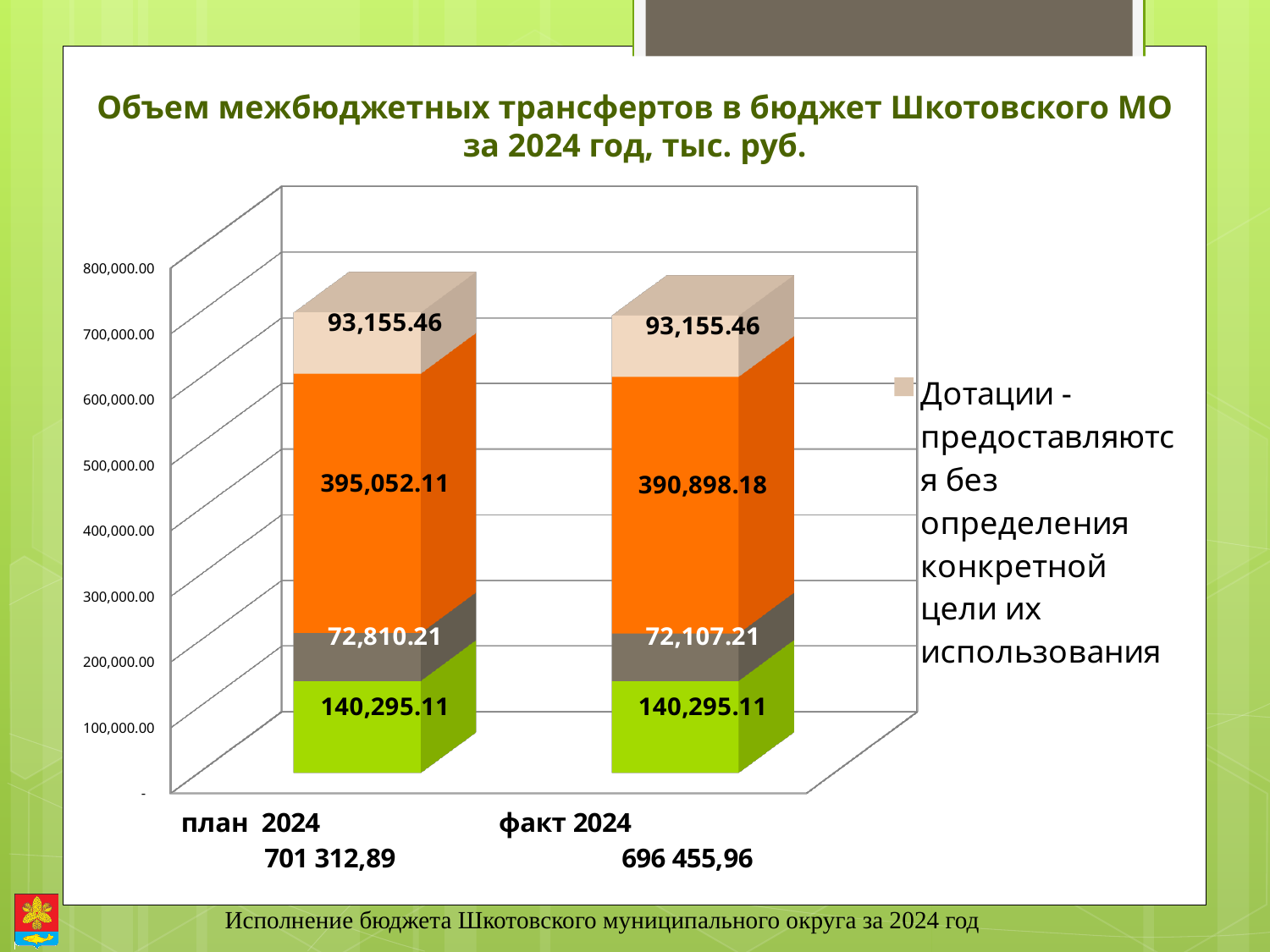
What is the value of the bottom green segment in the план 2024 bar? 140,295.11 What is the total shown for the факт 2024 bar? 696 455,96 How many categories are shown on the x axis? 2 What is the value of the orange segment in the факт 2024 bar? 390,898.18 What is the total shown for the план 2024 bar? 701 312,89 What is the difference between the orange segment values for план 2024 and факт 2024? 4,153.93 What is the value of the Дотации segment for факт 2024? 93,155.46 Which bar has the larger grey segment, план 2024 or факт 2024? план 2024 What type of chart is shown on the slide? Stacked bar chart What is the value of the Дотации segment for план 2024? 93,155.46 What is the value of the grey segment in the факт 2024 bar? 72,107.21 What is the value of the orange segment in the план 2024 bar? 395,052.11